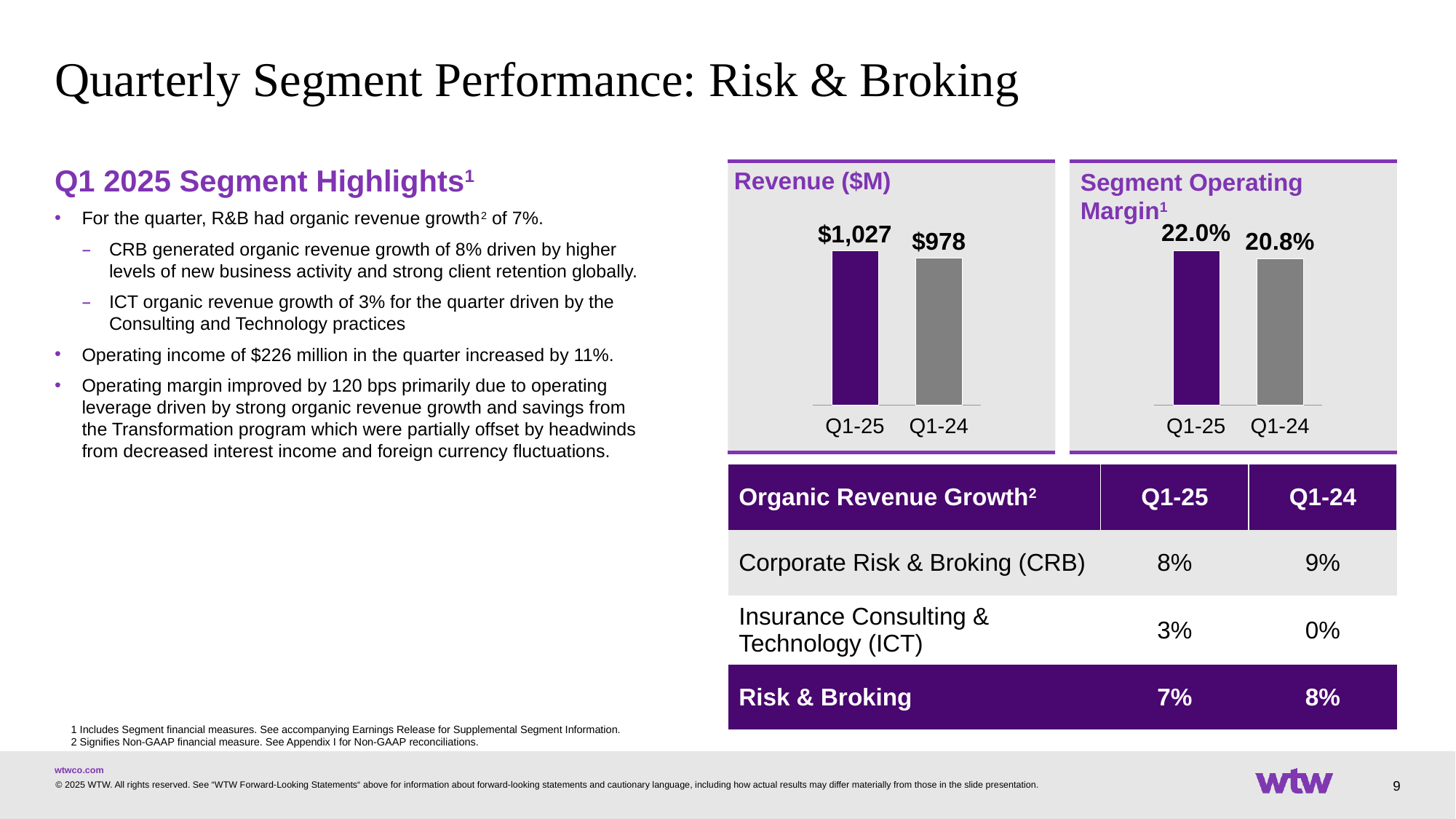
In the Revenue ($M) chart, what is the value for Q1-24? $978 In the Segment Operating Margin chart, is the value for Q1-25 larger or smaller than the value for Q1-24? larger In the Segment Operating Margin chart, what is the value for Q1-24? 20.8% In the Revenue ($M) chart, what is the difference between the Q1-25 and Q1-24 values? $49 In the Segment Operating Margin chart, what is the difference between the Q1-25 and Q1-24 values? 1.2% What type of chart is the Segment Operating Margin chart? bar chart In the Revenue ($M) chart, what colour is the Q1-25 bar? purple In the Segment Operating Margin chart, which quarter has the lower margin? Q1-24 In the Revenue ($M) chart, what is the value for Q1-25? $1,027 How many bars are shown in the Revenue ($M) chart? 2 In the Revenue ($M) chart, which quarter has the higher revenue? Q1-25 In the Segment Operating Margin chart, what is the value for Q1-25? 22.0%